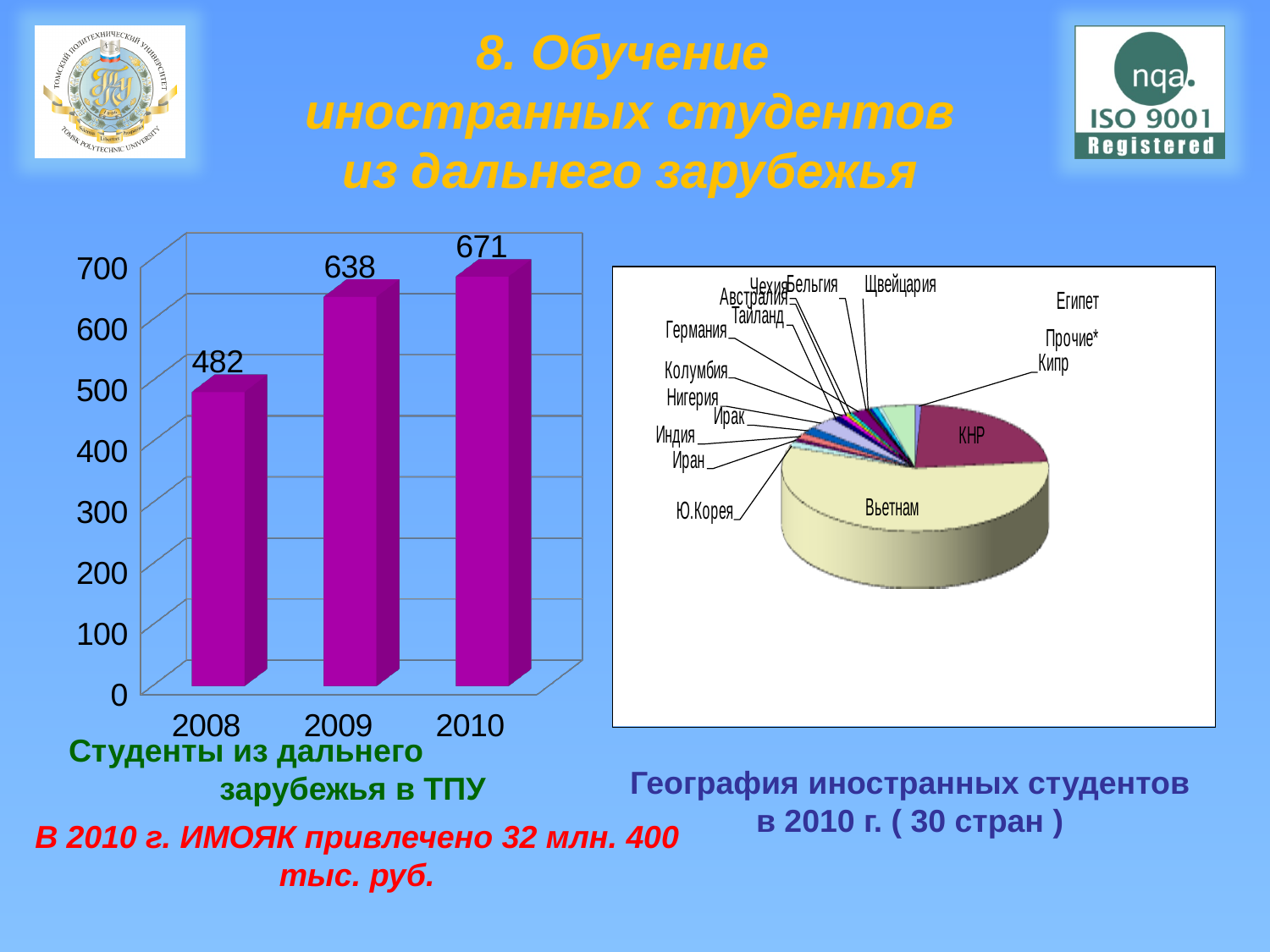
On the bar chart on the left, which year has the highest value? 2010 On the pie chart on the right, which country has the largest slice? Вьетнам On the bar chart on the left, how many years are shown? 3 On the bar chart on the left, what is the value for 2009? 638 On the bar chart on the left, do the values rise or fall from 2008 to 2010? rise On the bar chart on the left, what is the value for 2010? 671 On the bar chart on the left, what is the difference between the values for 2010 and 2008? 189 What kind of chart is the chart on the left of the slide? bar chart On the bar chart on the left, what is the value for 2008? 482 On the bar chart on the left, what is the difference between the values for 2009 and 2008? 156 On the bar chart on the left, which year has the lowest value? 2008 What kind of chart is the chart on the right of the slide? pie chart